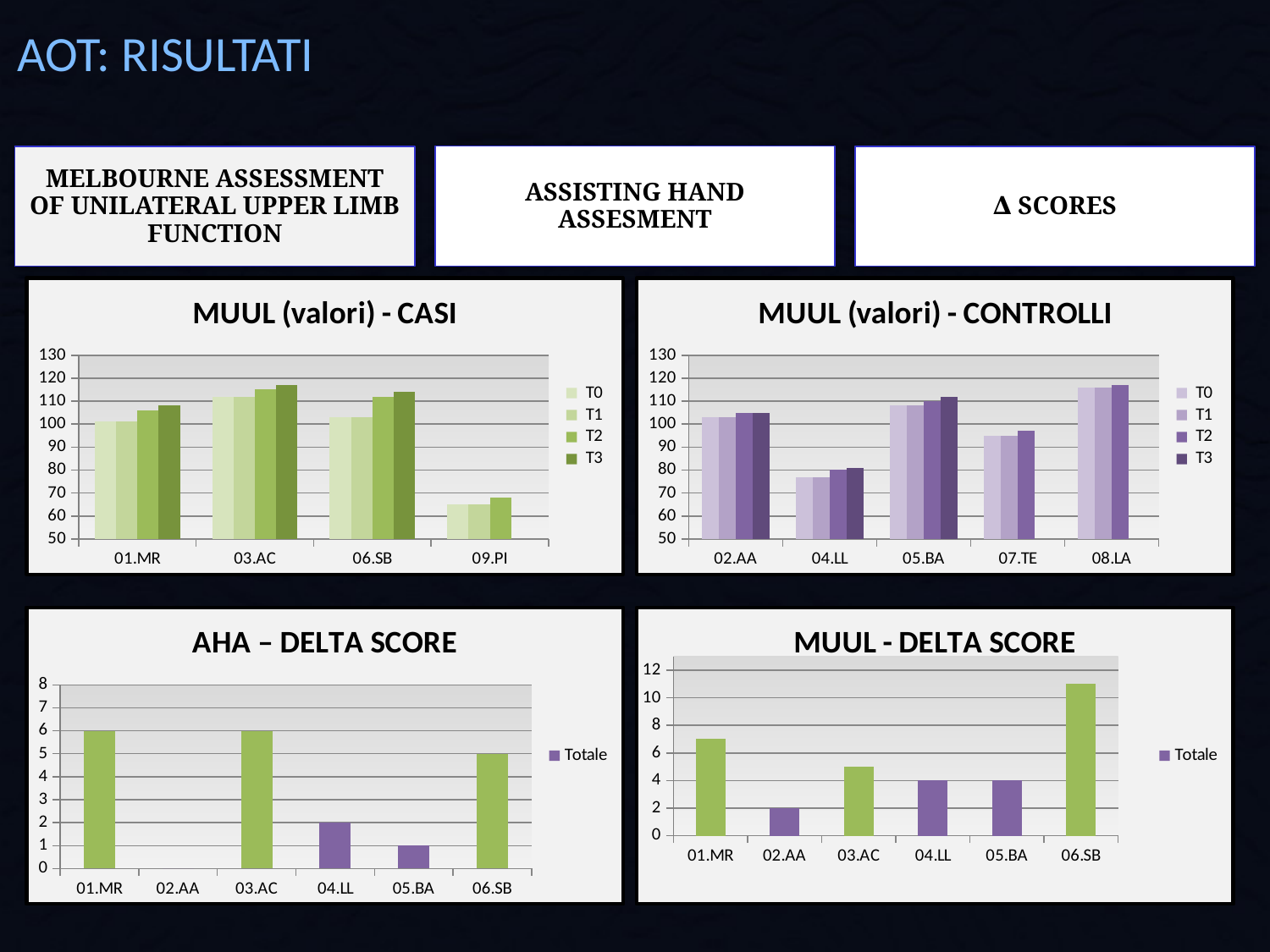
In the MUUL - DELTA SCORE chart, is the value for 06.SB greater or less than 10? greater In the AHA – DELTA SCORE chart, what is the value for 06.SB? 5 In the MUUL - DELTA SCORE chart, what is the value for 02.AA? 2 How many series does the legend of the MUUL (valori) - CASI chart list? 4 In the AHA – DELTA SCORE chart, what is the value for 05.BA? 1 In the AHA – DELTA SCORE chart, what is the difference between the values for 01.MR and 04.LL? 4 How many categories are shown on the x axis of the MUUL (valori) - CONTROLLI chart? 5 In the AHA – DELTA SCORE chart, what is the value for 04.LL? 2 What type of chart is the MUUL (valori) - CONTROLLI chart? bar chart In the MUUL - DELTA SCORE chart, which category has the highest value? 06.SB In the AHA – DELTA SCORE chart, which category has the lowest value? 02.AA